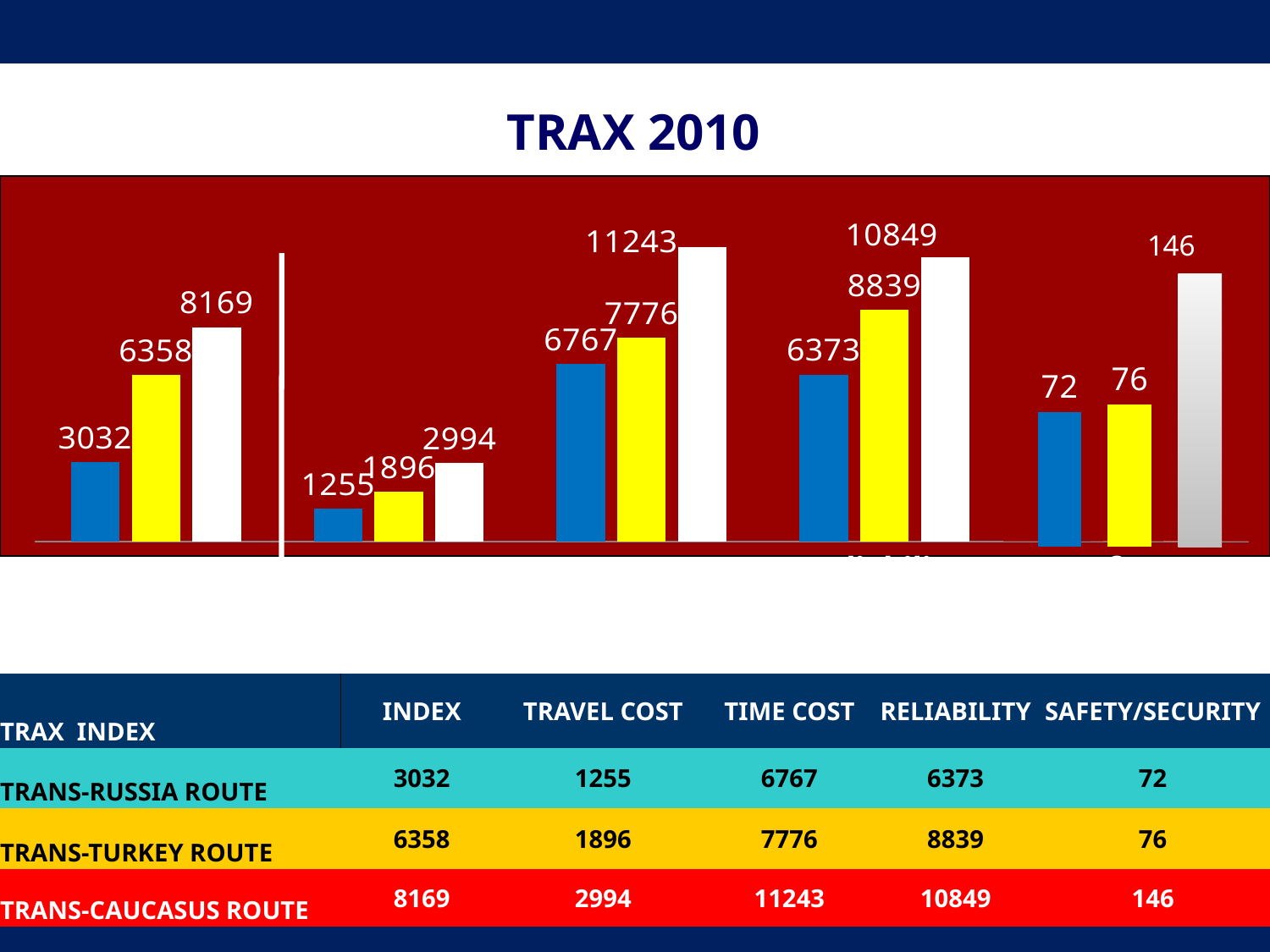
What is the value of the tallest bar in the chart? 11243 In the first group of bars, what is the difference between the white bar (8169) and the blue bar (3032)? 5137 Which is larger: the Trans-Turkey RELIABILITY value or the Trans-Turkey TIME COST value? RELIABILITY (8839) What is the difference between the two tallest bars in the TIME COST group (11243 and 7776)? 3467 Within each category group, do the bar values rise or fall from the blue bar to the white bar? rise How many groups of bars (categories) does the chart show? 5 What is the value of the shortest bar in the chart? 1255 How many bars are in each category group of the chart? 3 What is the title shown above the chart? TRAX 2010 According to the table, what is the RELIABILITY value for the Trans-Caucasus route? 10849 What type of chart is shown on the slide? bar chart According to the table, what is the INDEX value for the Trans-Turkey route? 6358